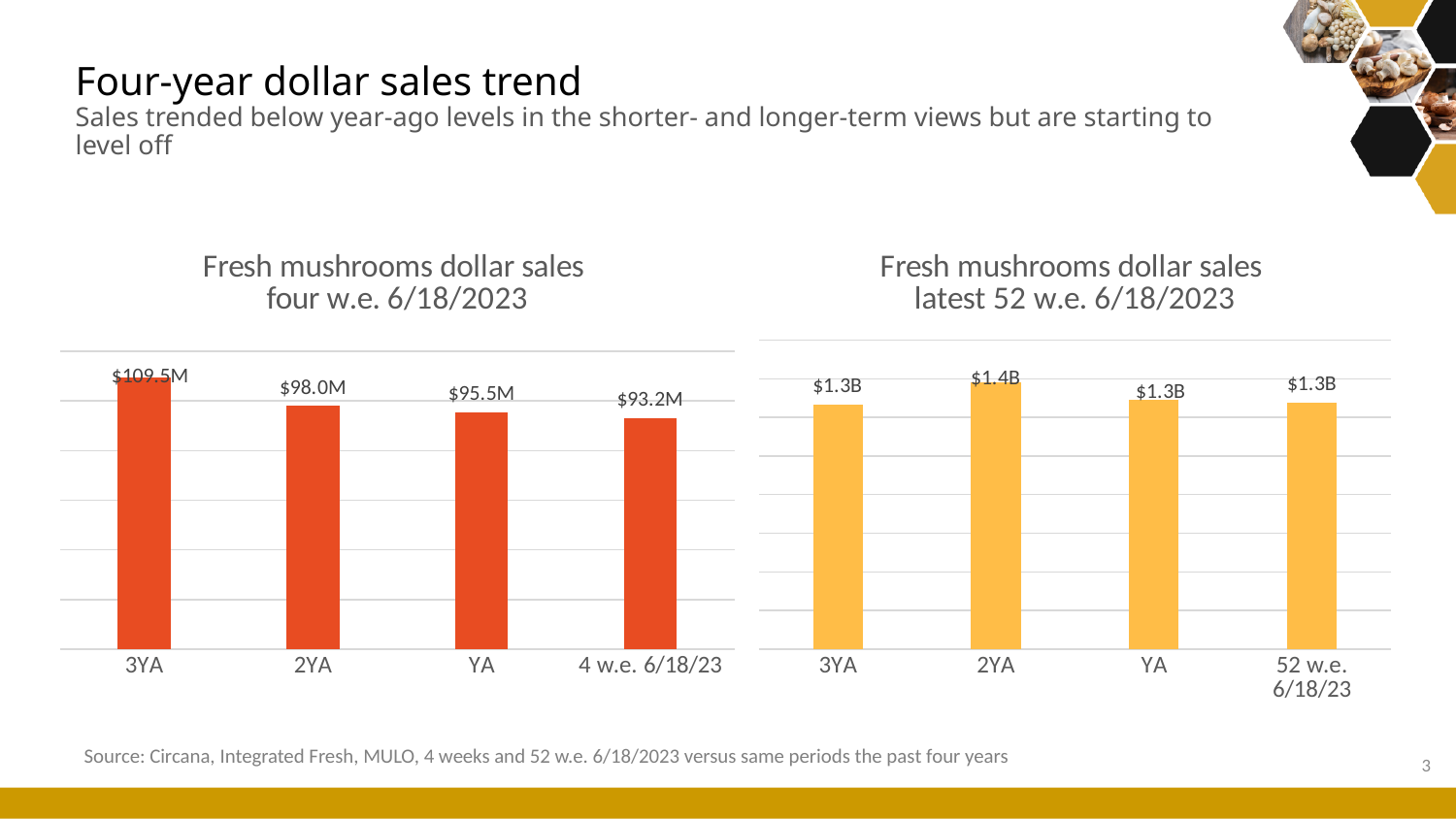
In the 'Fresh mushrooms dollar sales latest 52 w.e. 6/18/2023' chart, which is larger, the value for 2YA or the value for YA? 2YA How many periods are shown on the x axis of the 'Fresh mushrooms dollar sales latest 52 w.e. 6/18/2023' chart? 4 What type of chart is the 'Fresh mushrooms dollar sales four w.e. 6/18/2023' chart? bar chart In the 'Fresh mushrooms dollar sales four w.e. 6/18/2023' chart, what is the difference between the 3YA value and the 4 w.e. 6/18/23 value? $16.4M In the 'Fresh mushrooms dollar sales four w.e. 6/18/2023' chart, what is the difference between the 2YA value and the YA value? $2.5M In the 'Fresh mushrooms dollar sales four w.e. 6/18/2023' chart, which period has the highest value? 3YA In the 'Fresh mushrooms dollar sales four w.e. 6/18/2023' chart, what is the value for 3YA? $109.5M In the 'Fresh mushrooms dollar sales four w.e. 6/18/2023' chart, which period has the lowest value? 4 w.e. 6/18/23 In the 'Fresh mushrooms dollar sales latest 52 w.e. 6/18/2023' chart, which period has the highest value? 2YA In the 'Fresh mushrooms dollar sales latest 52 w.e. 6/18/2023' chart, what is the value for 2YA? $1.4B In the 'Fresh mushrooms dollar sales four w.e. 6/18/2023' chart, what is the value for 4 w.e. 6/18/23? $93.2M In the 'Fresh mushrooms dollar sales four w.e. 6/18/2023' chart, do the values rise or fall from 3YA to 4 w.e. 6/18/23? fall